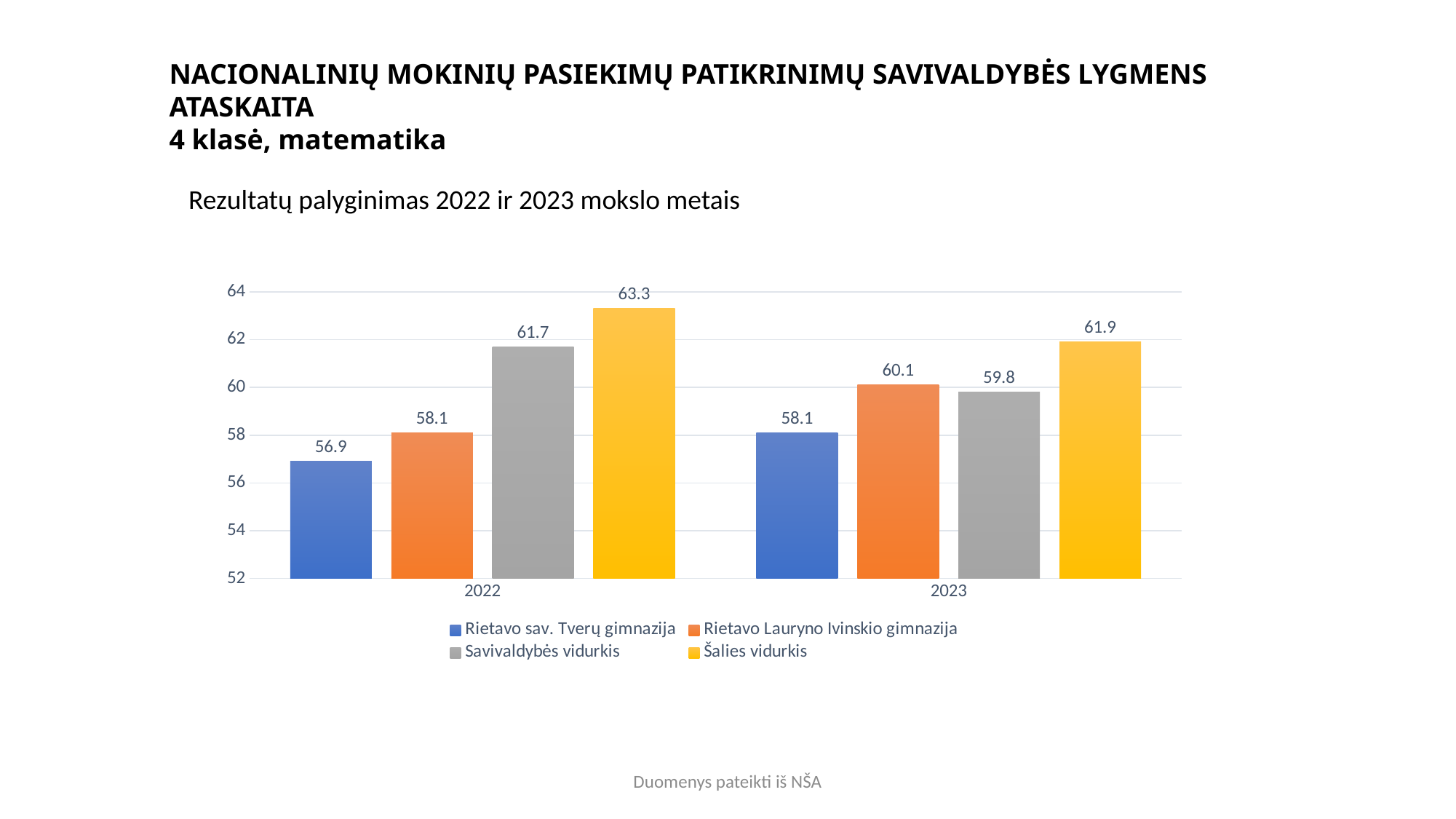
What is the value for Rietavo sav. Tverų gimnazija in 2022? 56.9 Which series has the highest value in 2022? Šalies vidurkis Which series has the lowest value in 2023? Rietavo sav. Tverų gimnazija What is the value for Savivaldybės vidurkis in 2022? 61.7 What is the difference between Rietavo Lauryno Ivinskio gimnazija and Rietavo sav. Tverų gimnazija in 2022? 1.2 How many year categories are shown on the x axis? 2 What kind of chart is shown on the slide? Bar chart How many series does the legend list? 4 What is the value for Rietavo Lauryno Ivinskio gimnazija in 2023? 60.1 What is the difference between Šalies vidurkis in 2022 and in 2023? 1.4 What is the value for Šalies vidurkis in 2023? 61.9 Which is larger in 2023: Rietavo Lauryno Ivinskio gimnazija or Savivaldybės vidurkis? Rietavo Lauryno Ivinskio gimnazija